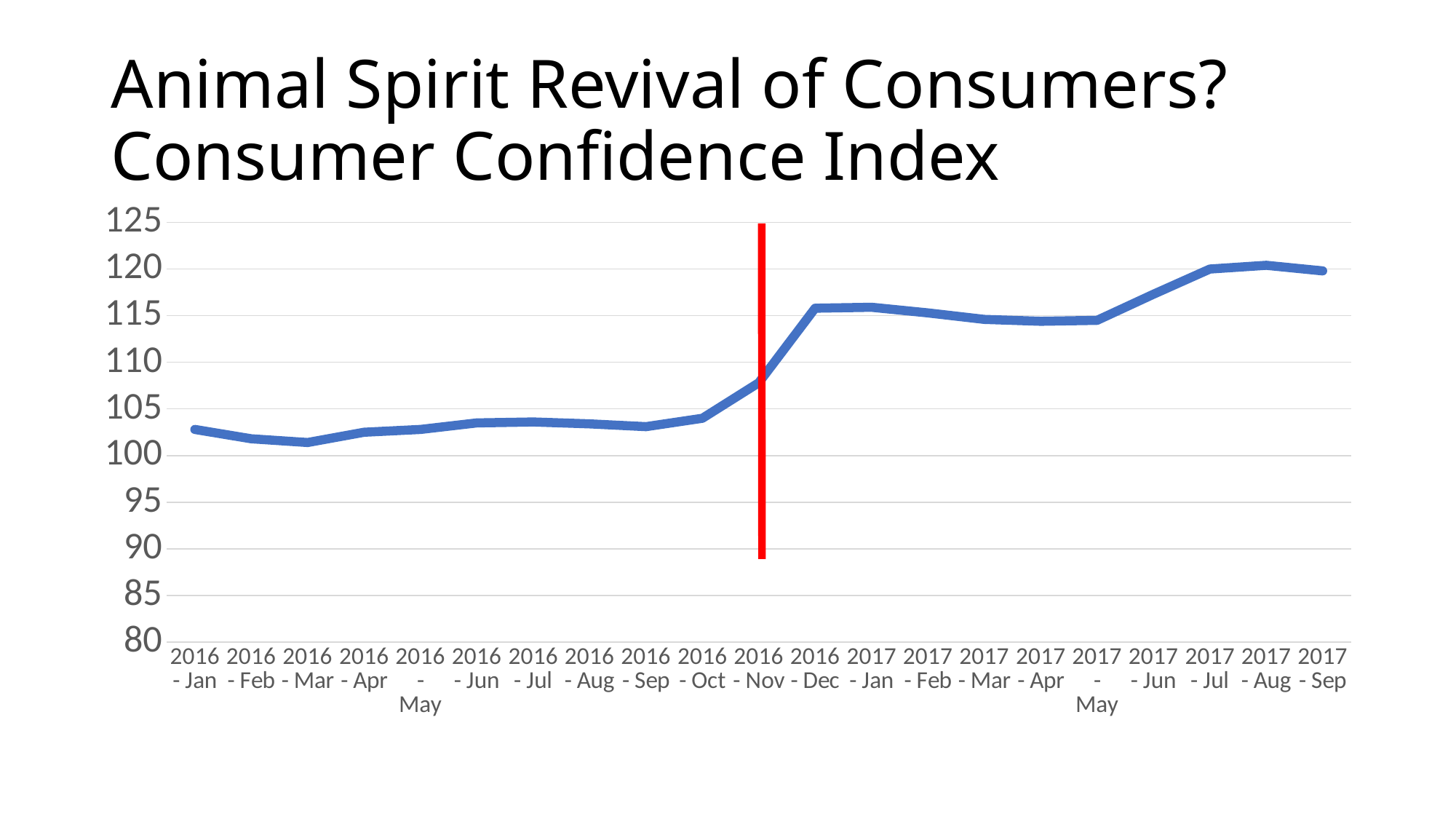
At which month is the red vertical line placed on the chart? 2016 - Nov Is the value for 2016 - Nov greater or less than 105? greater How many monthly data points are plotted on the chart? 21 Is the value for 2017 - Mar greater or less than 110? greater Which is larger, the value for 2016 - Oct or the value for 2016 - Dec? 2016 - Dec Does the line rise or fall between 2016 - Oct and 2016 - Dec? rise Is the value for 2016 - Nov greater or less than 110? less What kind of chart is shown on the slide? line chart Does the line rise or fall between 2017 - Jan and 2017 - Apr? fall Which is larger, the value for 2016 - Jan or the value for 2017 - Jan? 2017 - Jan